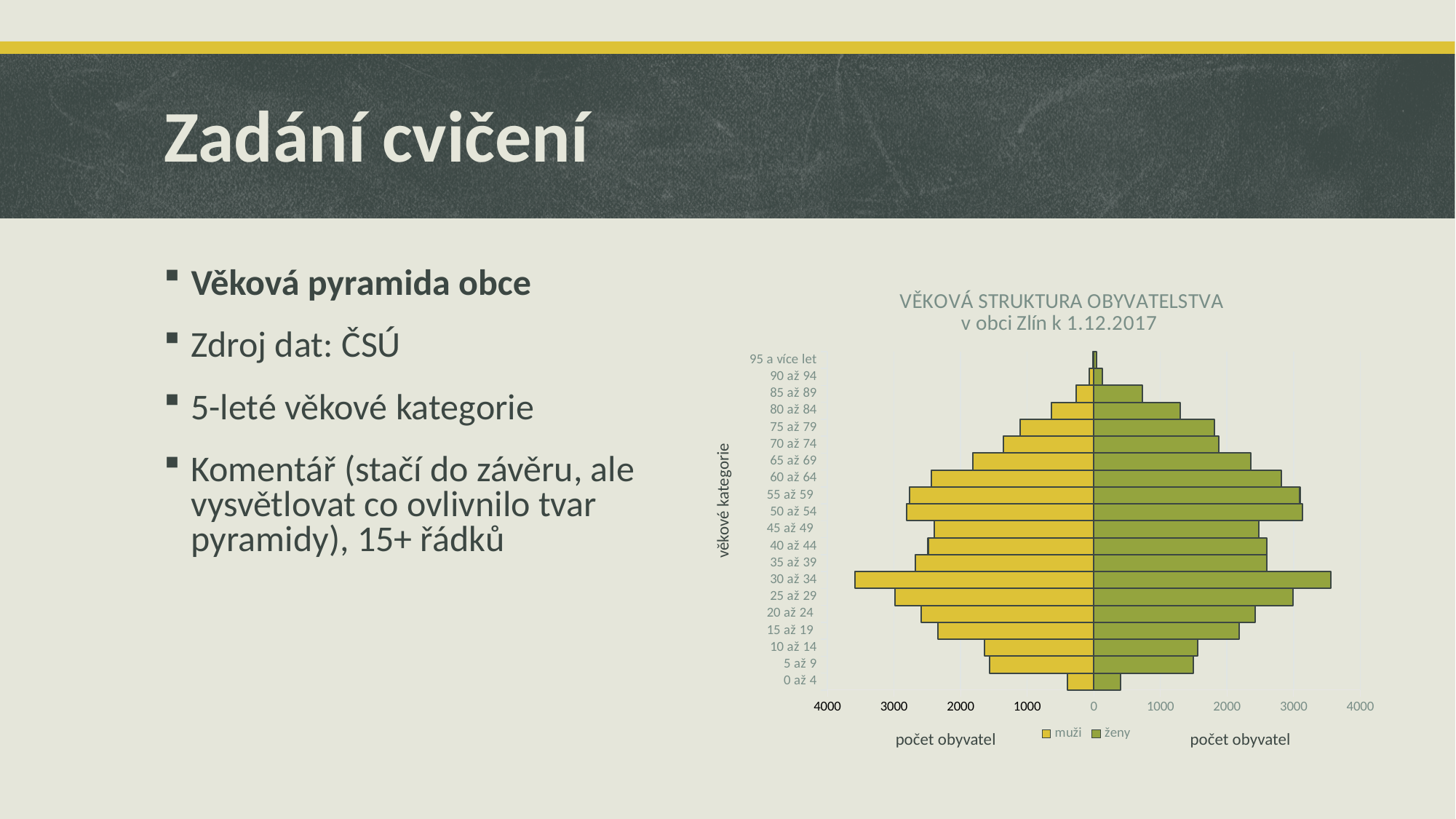
Which age category has the largest value for muži? 30 až 34 Is the value for muži in the 30 až 34 category greater or less than 3000? greater What kind of chart is shown on the slide? bar chart Which age category has the largest value for ženy? 30 až 34 How many age categories are shown on the vertical axis of the chart? 20 In the 80 až 84 category, which series has the larger value, muži or ženy? ženy What is the title of the chart? VĚKOVÁ STRUKTURA OBYVATELSTVA v obci Zlín k 1.12.2017 Is the value for muži in the 0 až 4 category greater or less than 1000? less How many series does the legend of the chart list? 2 Which age category has the smallest value for ženy? 95 a více let Is the value for ženy in the 85 až 89 category greater or less than 1000? less